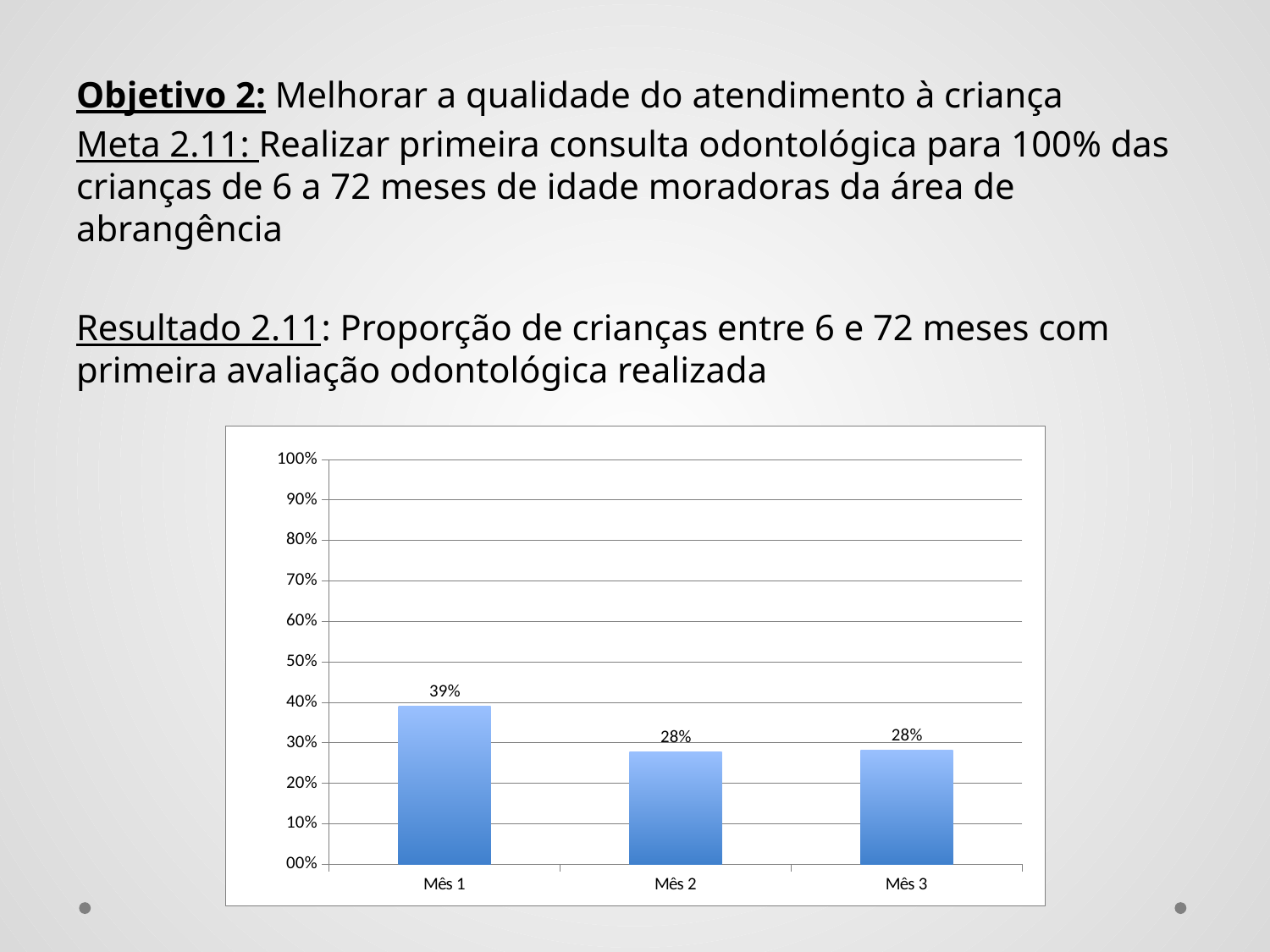
What is the value for Mês 3? 28% What kind of chart is shown on the slide? bar chart Do the values rise or fall from Mês 1 to Mês 2? fall How many categories are shown on the x axis? 3 What is the difference between the values for Mês 1 and Mês 2? 11% What is the maximum value shown on the y axis? 100% What is the value for Mês 2? 28% Which is larger, the value for Mês 1 or the value for Mês 3? Mês 1 Is the value for Mês 2 greater or less than 20%? greater Is the value for Mês 1 greater or less than 50%? less Which month has the highest value? Mês 1 What is the value for Mês 1? 39%